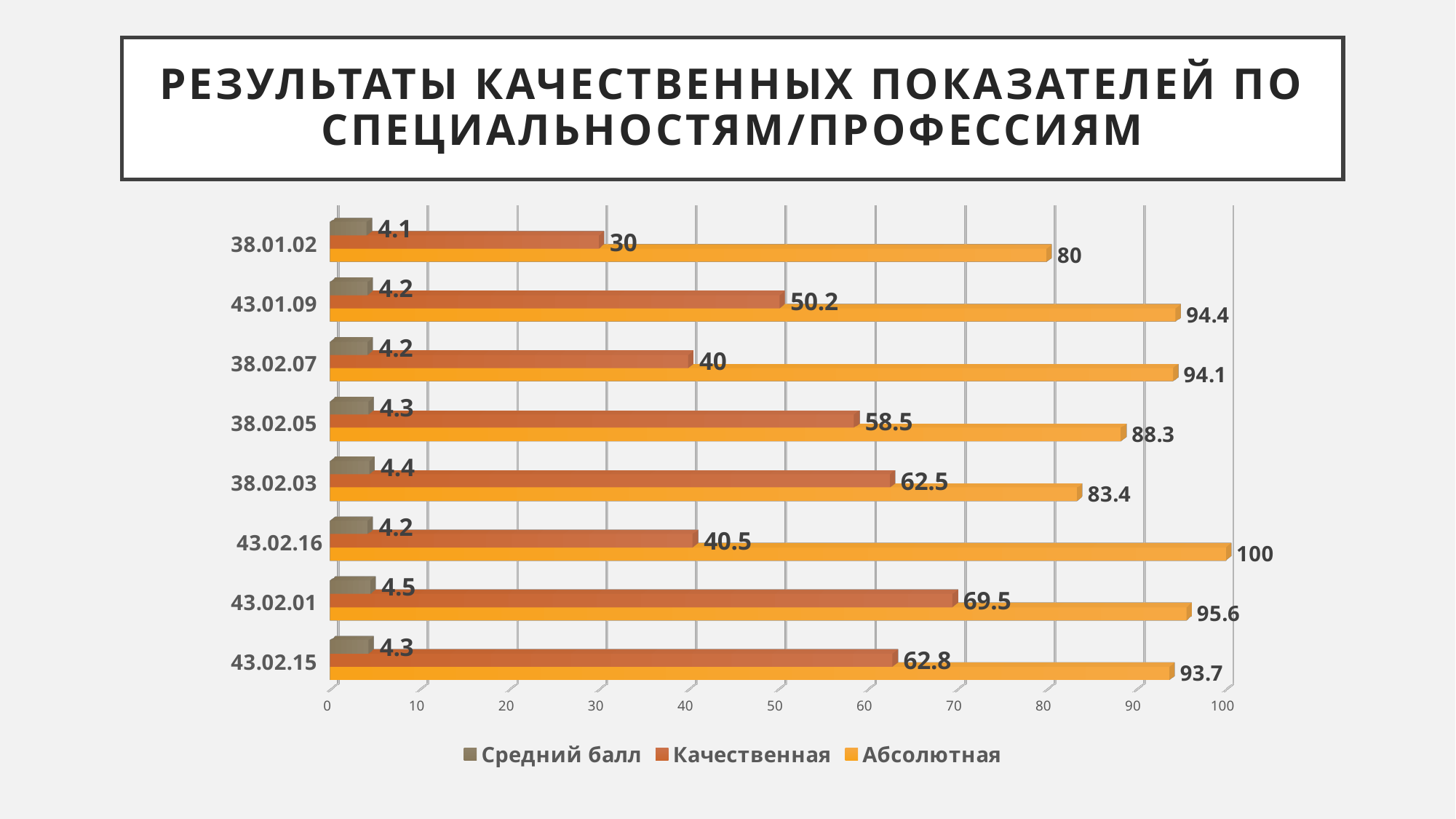
How many series does the legend list? 3 What is the Качественная value for 38.02.05? 58.5 How many categories are shown on the chart? 8 Which is larger: the Качественная value for 38.02.03 or for 43.02.15? 43.02.15 What is the difference between the Абсолютная and Качественная values for 38.01.02? 50 Which series is shown in the lightest orange colour? Абсолютная Which category has the lowest Абсолютная value? 38.01.02 What is the difference between the Абсолютная values for 43.01.09 and 38.02.07? 0.3 What is the Абсолютная value for 43.02.16? 100 What kind of chart is shown on the slide? bar chart What is the Средний балл value for 43.02.01? 4.5 Which category has the highest Качественная value? 43.02.01